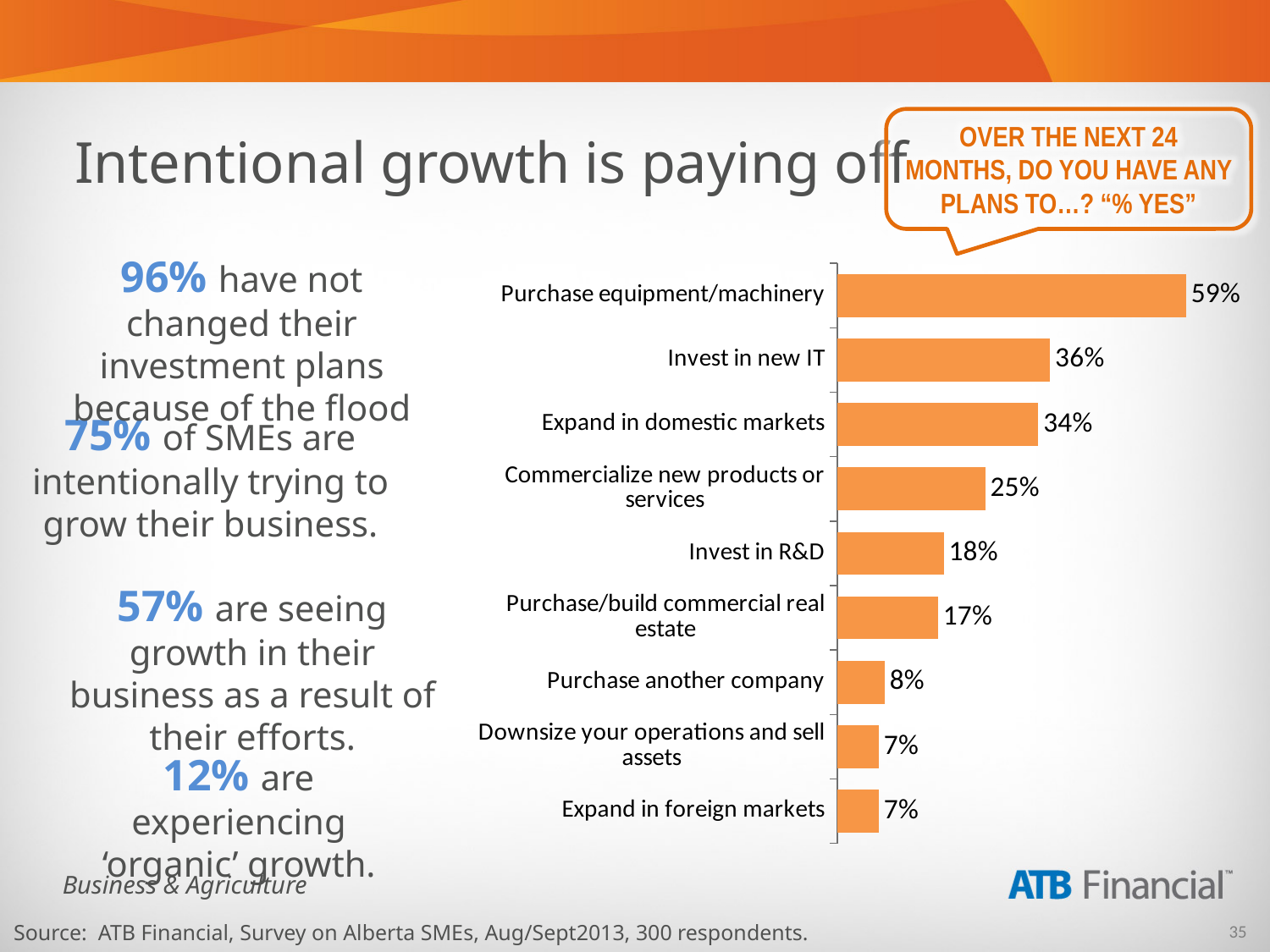
What kind of chart is shown on the slide? Bar chart What question does the chart's callout title say respondents were asked? Over the next 24 months, do you have any plans to…? "% yes" What is the difference between the values for 'Invest in new IT' and 'Expand in domestic markets'? 2% What is the value shown for 'Commercialize new products or services'? 25% What is the value shown for 'Invest in R&D'? 18% Which is larger: the value for 'Invest in R&D' or the value for 'Purchase/build commercial real estate'? Invest in R&D What percentage of SMEs plan to purchase equipment/machinery over the next 24 months? 59% Which two categories share the lowest value of 7%? Downsize your operations and sell assets; Expand in foreign markets What is the value shown for 'Purchase another company'? 8% How many categories are shown in the chart? 9 Which category has the highest value in the chart? Purchase equipment/machinery What is the difference between 'Purchase equipment/machinery' and 'Purchase another company'? 51%